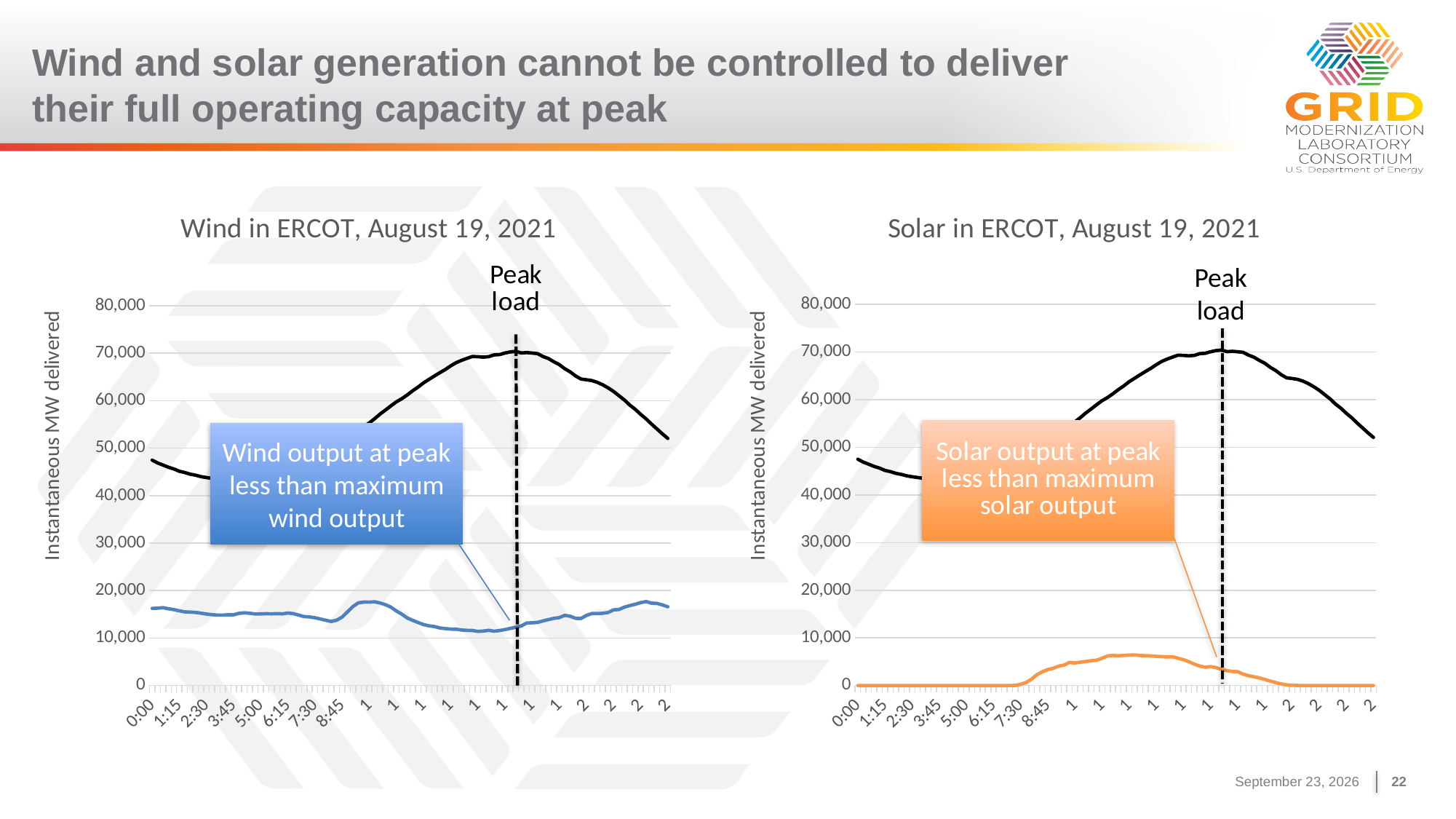
In the 'Solar in ERCOT, August 19, 2021' chart, what does the dashed vertical line mark? Peak load In the 'Wind in ERCOT, August 19, 2021' chart, is the wind output at 0:00 greater or less than 10,000? greater In the 'Wind in ERCOT, August 19, 2021' chart, what is the label on the vertical axis? Instantaneous MW delivered In the 'Wind in ERCOT, August 19, 2021' chart, is the load at the peak load line greater or less than 60,000? greater In the 'Solar in ERCOT, August 19, 2021' chart, is the solar output at the peak load line greater or less than 10,000? less In the 'Wind in ERCOT, August 19, 2021' chart, at the peak load line, which is higher: the black load line or the blue wind line? the black load line In the 'Solar in ERCOT, August 19, 2021' chart, does the black load line rise or fall between 0:00 and 5:00? fall What kind of chart is the 'Wind in ERCOT, August 19, 2021' chart? line chart What kind of chart is the 'Solar in ERCOT, August 19, 2021' chart? line chart